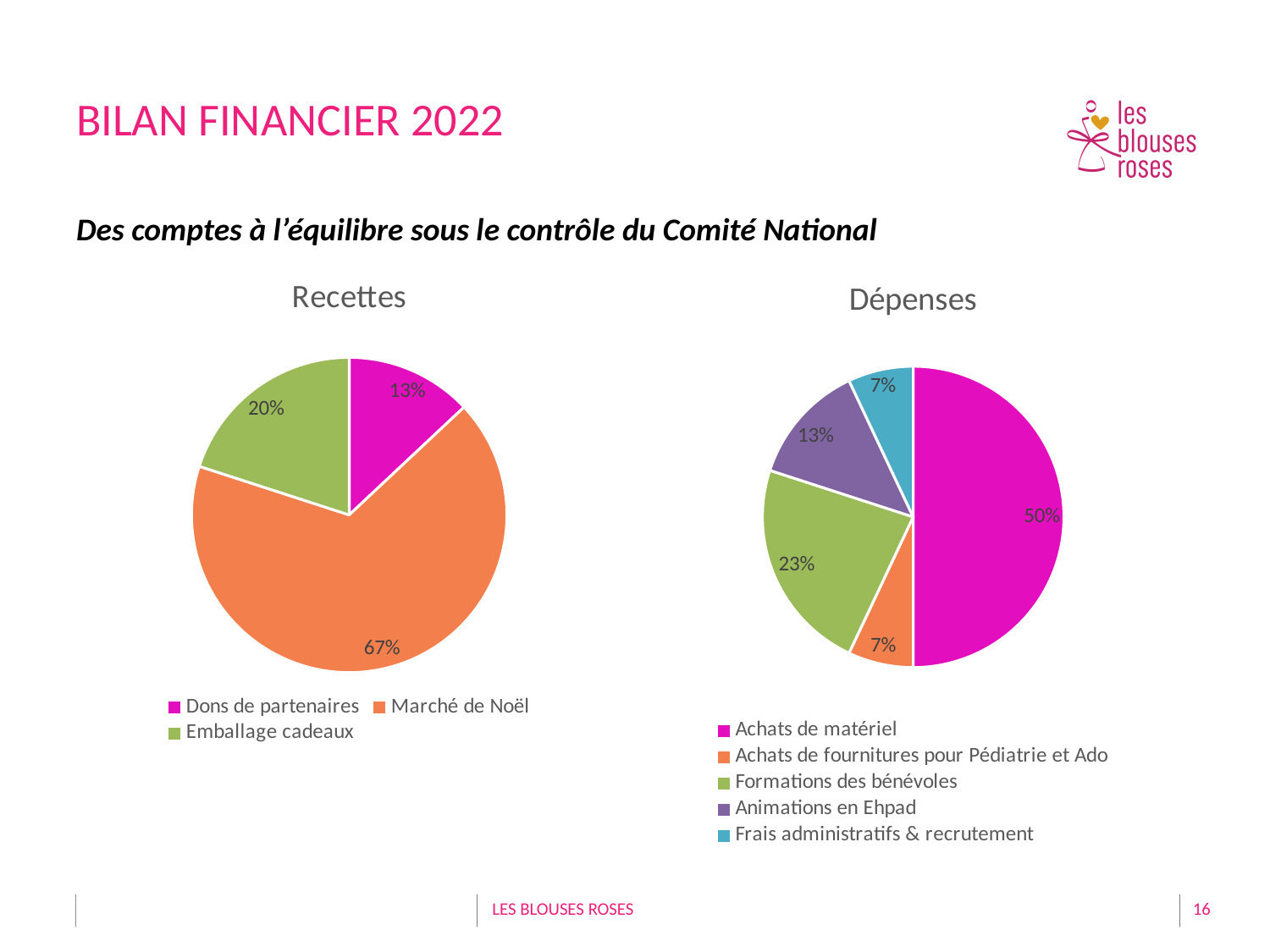
In the Dépenses chart, what share does Achats de matériel represent? 50% In the Recettes chart, what share does Marché de Noël represent? 67% In the Recettes chart, which category has the largest share? Marché de Noël In the Recettes chart, what share does Emballage cadeaux represent? 20% In the Dépenses chart, how many categories does the legend list? 5 In the Recettes chart, how many categories are shown? 3 In the Recettes chart, what is the difference in percentage points between Marché de Noël and Emballage cadeaux? 47 What type of chart is the Dépenses chart? Pie chart In the Recettes chart, which category has the smallest share? Dons de partenaires In the Dépenses chart, which category has the largest share? Achats de matériel